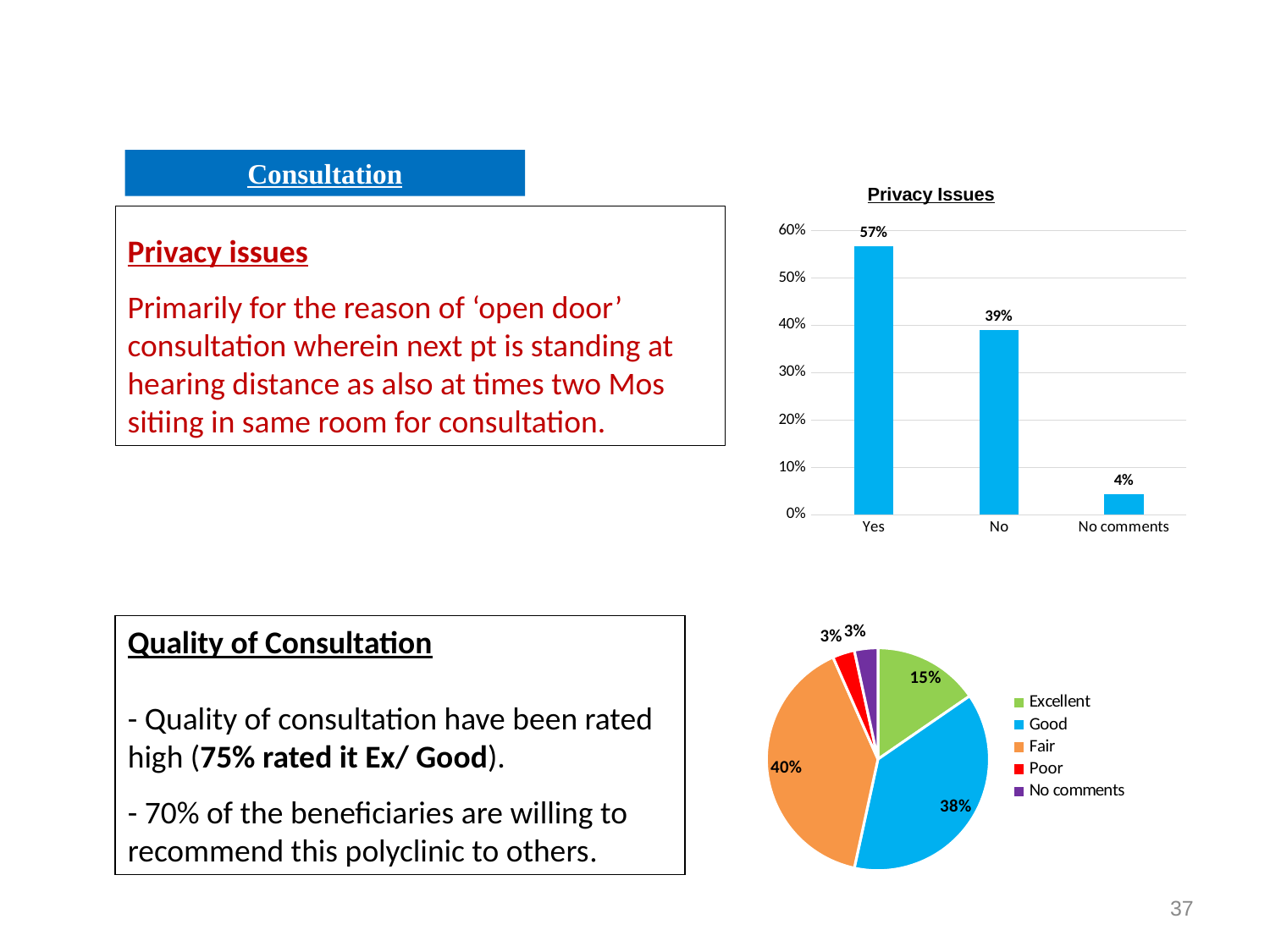
What kind of chart is the Privacy Issues chart? Bar chart In the Privacy Issues bar chart, which category has the lowest value? No comments In the Privacy Issues bar chart, how many categories are shown on the x axis? 3 In the Privacy Issues bar chart, which category has the highest value? Yes In the pie chart at the bottom right, what share does Good have? 38% In the pie chart at the bottom right, which is larger, Fair or Excellent? Fair In the Privacy Issues bar chart, what is the value for Yes? 57% How many entries does the legend of the pie chart at the bottom right list? 5 In the pie chart at the bottom right, what is the value for Excellent? 15% In the Privacy Issues bar chart, what is the difference between the values for Yes and No? 18% In the Privacy Issues bar chart, what is the value for No comments? 4% In the pie chart at the bottom right, what share does Fair have? 40%